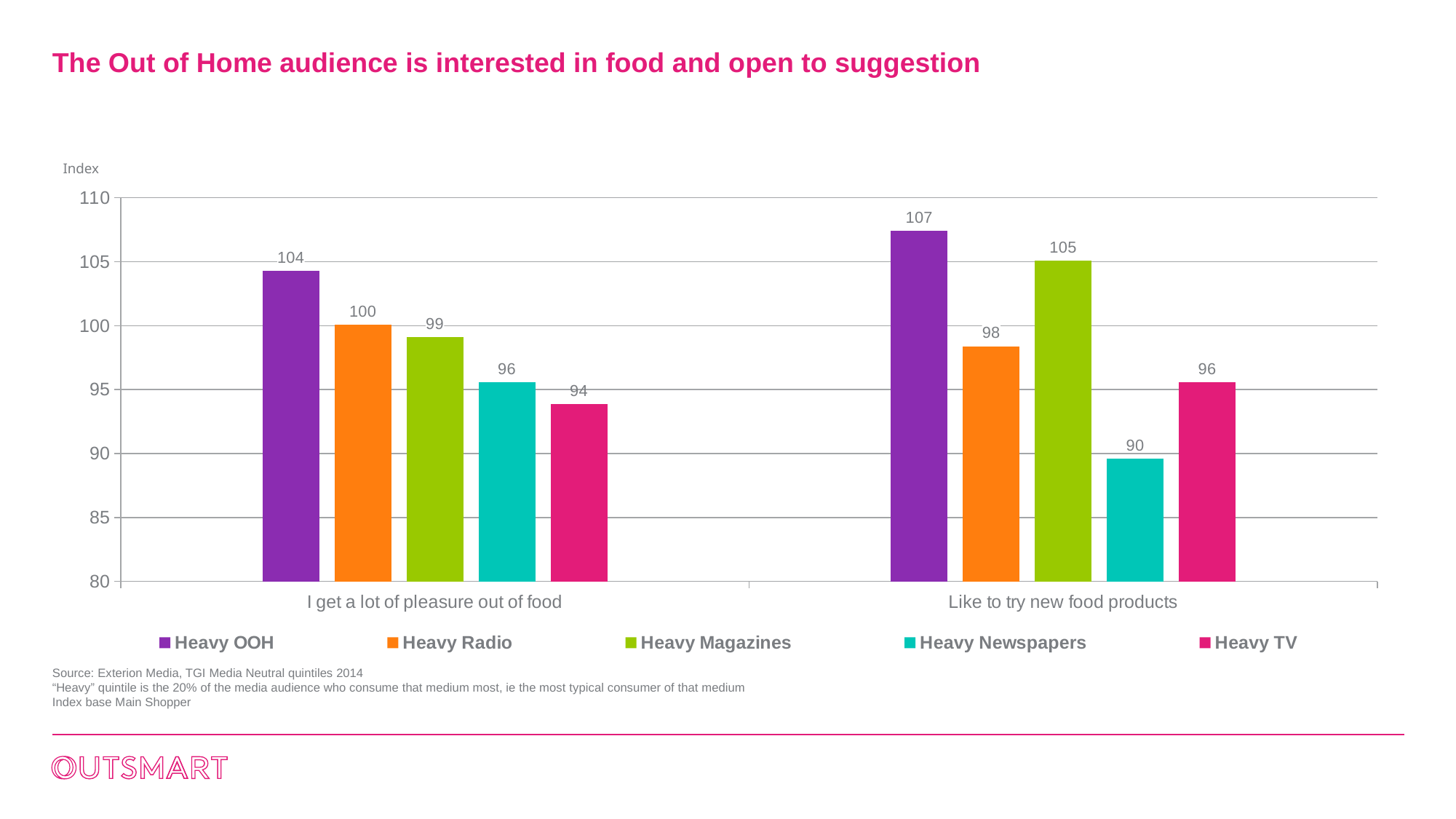
What is the difference between the Heavy OOH and Heavy TV index values for 'Like to try new food products'? 11 How many categories are shown on the x axis? 2 How many series does the legend list? 5 Is the value for Heavy Radio for 'Like to try new food products' greater or less than 100? less Which is larger for 'I get a lot of pleasure out of food': Heavy Radio or Heavy Newspapers? Heavy Radio What is the index value for Heavy OOH for 'I get a lot of pleasure out of food'? 104 What is the index value for Heavy Newspapers for 'Like to try new food products'? 90 Which series has the highest index for 'Like to try new food products'? Heavy OOH What is the label of the y axis? Index Which series has the lowest index for 'I get a lot of pleasure out of food'? Heavy TV What kind of chart is shown on the slide? Bar chart What is the index value for Heavy Magazines for 'Like to try new food products'? 105